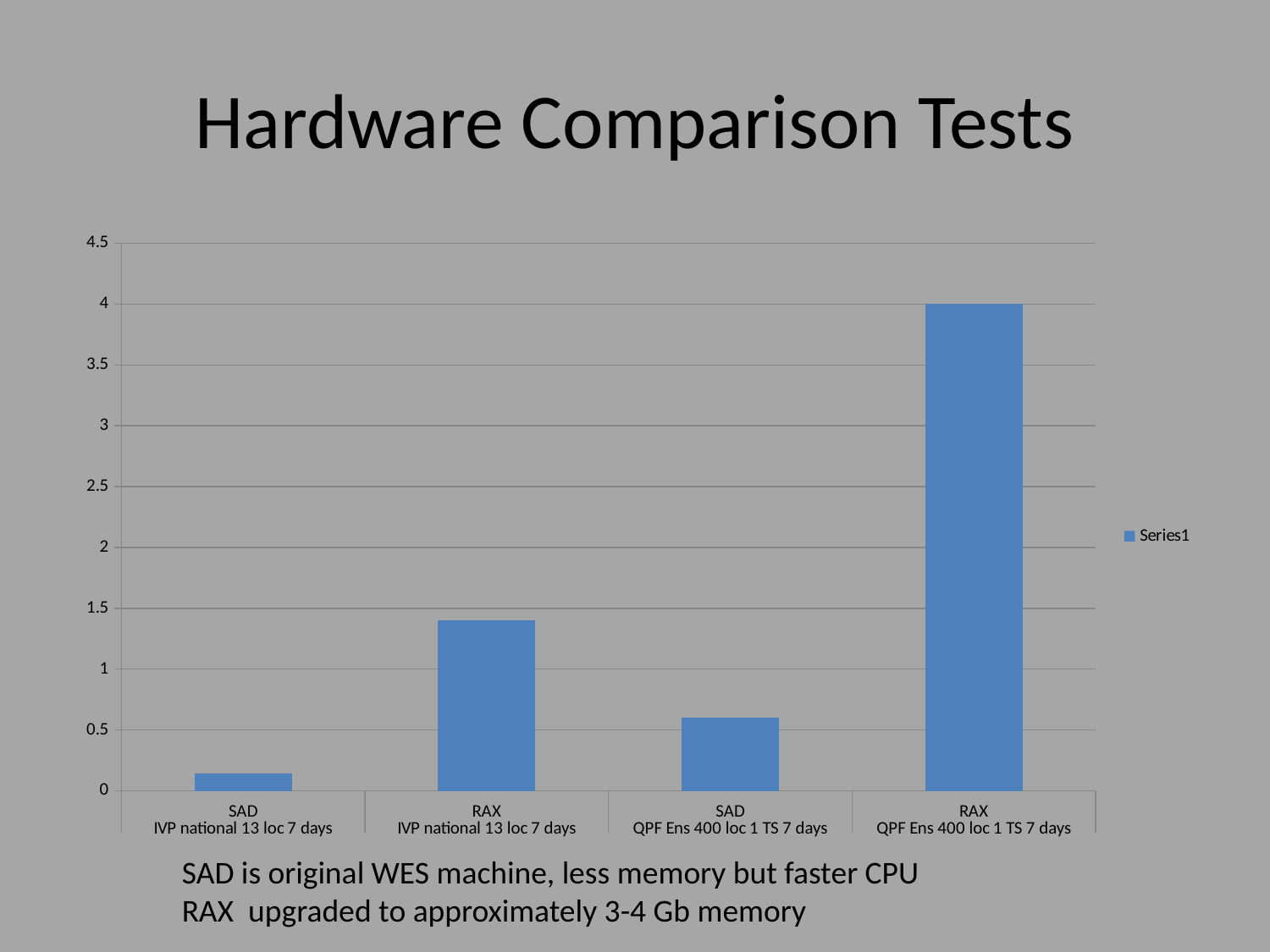
What type of chart is shown on the slide? bar chart Is the value for SAD IVP national 13 loc 7 days greater or less than 0.5? less How many series does the legend list? 1 Which category has the highest value? RAX QPF Ens 400 loc 1 TS 7 days Which is larger: the value for RAX IVP national 13 loc 7 days or the value for SAD QPF Ens 400 loc 1 TS 7 days? RAX IVP national 13 loc 7 days What is the title of the chart on the slide? Hardware Comparison Tests How many bars (categories) are plotted in the chart? 4 What is the name of the series shown in the legend? Series1 Which category has the lowest value? SAD IVP national 13 loc 7 days Is the value for RAX IVP national 13 loc 7 days greater or less than 1? greater Is the value for RAX QPF Ens 400 loc 1 TS 7 days greater or less than 3.5? greater